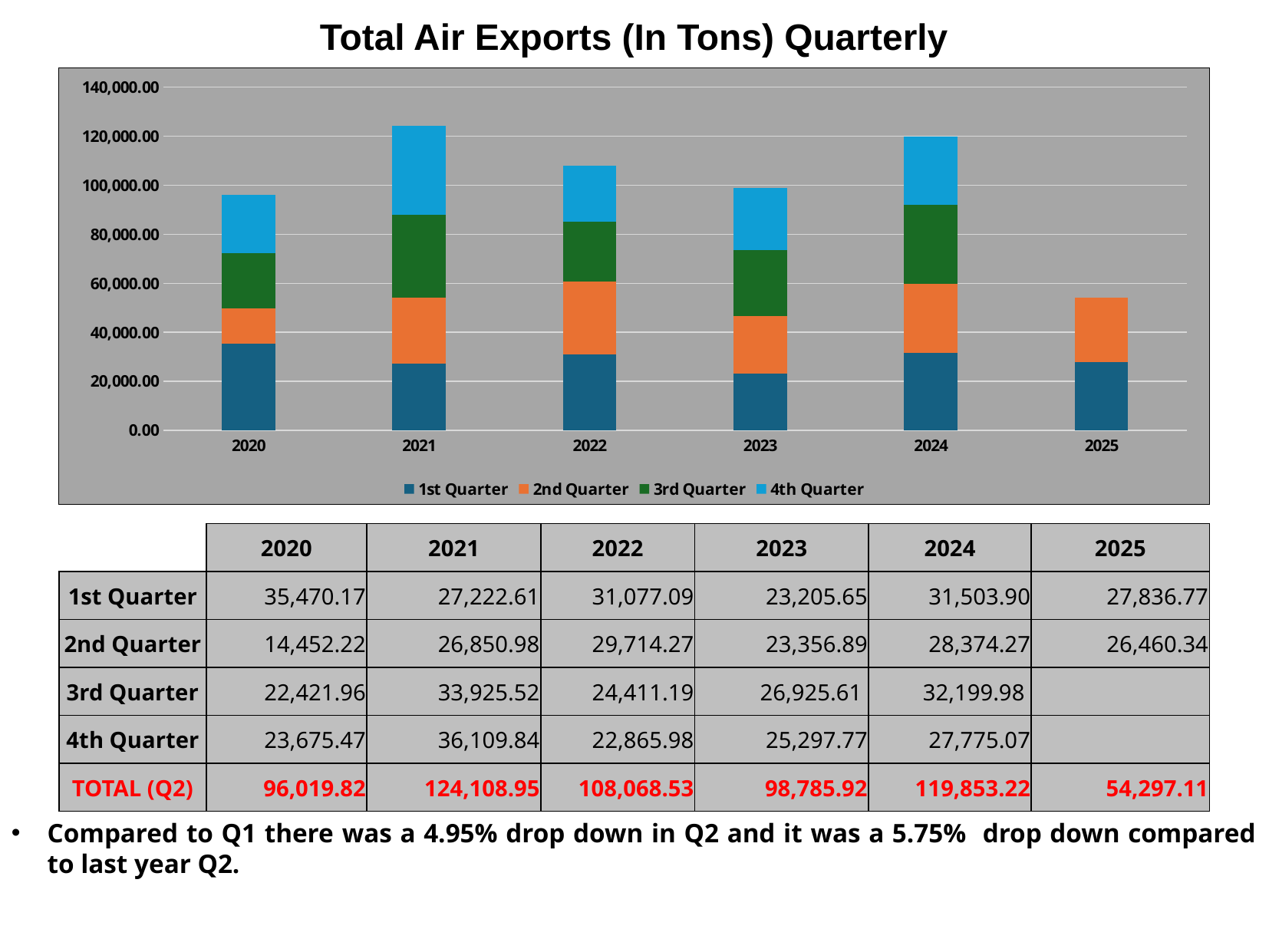
What is the difference between the 1st Quarter values for 2024 and 2023? 8,298.25 What is the title of the chart? Total Air Exports (In Tons) Quarterly How many series does the legend list? 4 Which year has the highest total air exports? 2021 What is the 1st Quarter value for 2020? 35,470.17 How many years are shown along the x axis? 6 What is the 4th Quarter value for 2021? 36,109.84 What is the total of the stacked bar for 2020? 96,019.82 Which year has the larger 3rd Quarter value, 2021 or 2024? 2021 Is the total for 2022 greater or less than 100,000.00? greater Which year has the lowest total air exports? 2025 What kind of chart is shown on the slide? Stacked bar chart